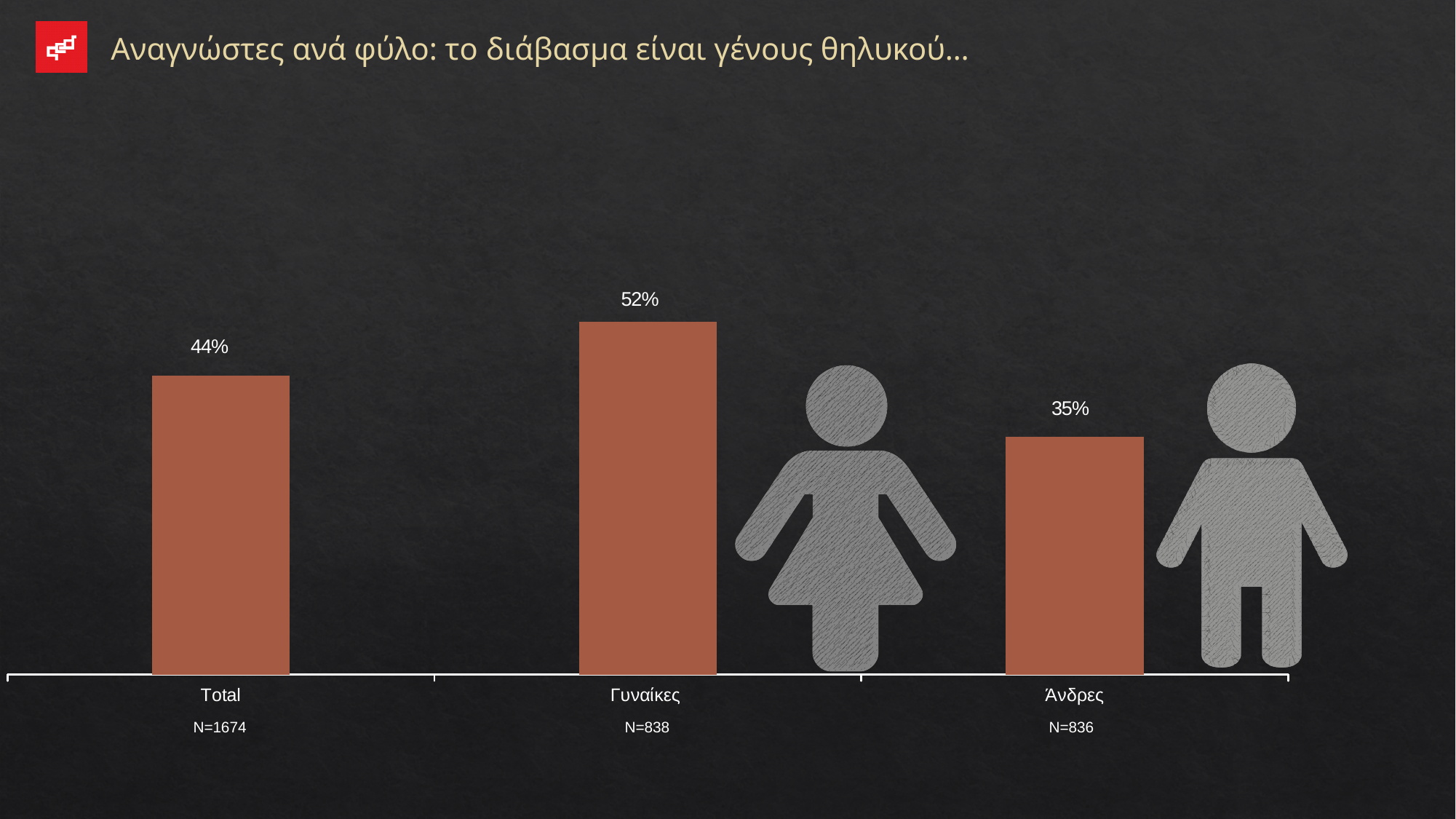
What is the value for Total? 44% How many categories are shown in the chart? 3 Which category has the highest value? Γυναίκες What is the sample size (N) shown under Total? N=1674 What is the difference between the values for Γυναίκες and Total? 8% What is the value for Άνδρες? 35% What is the difference between the values for Γυναίκες and Άνδρες? 17% Which category has the lowest value? Άνδρες What kind of chart is shown on the slide? Bar chart What is the value for Γυναίκες? 52% What is the sample size (N) shown under Γυναίκες? N=838 Which is larger, the value for Total or the value for Άνδρες? Total